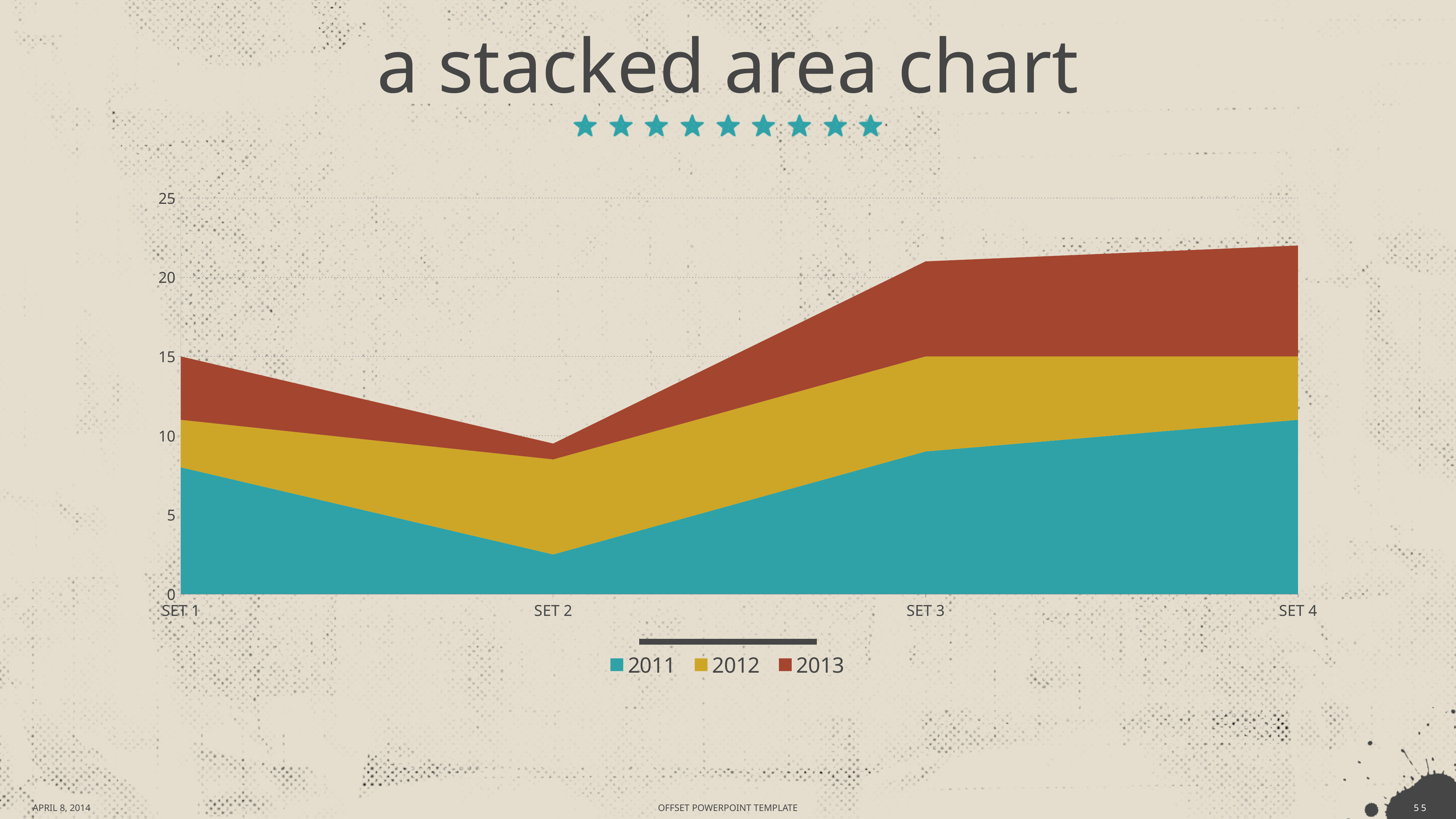
What kind of chart is shown on the slide? stacked area chart Which is larger for the 2011 series: SET 1 or SET 2? SET 1 At which category is the 2011 series lowest? SET 2 Which series is shown in the bottom (teal) area of the chart? 2011 How many categories are shown on the x axis? 4 Is the stacked total at SET 3 greater or less than 20? greater Is the value for 2011 at SET 4 greater or less than 10? greater Is the value for 2011 at SET 2 greater or less than 5? less How many series does the legend list? 3 What is the title of the chart? a stacked area chart